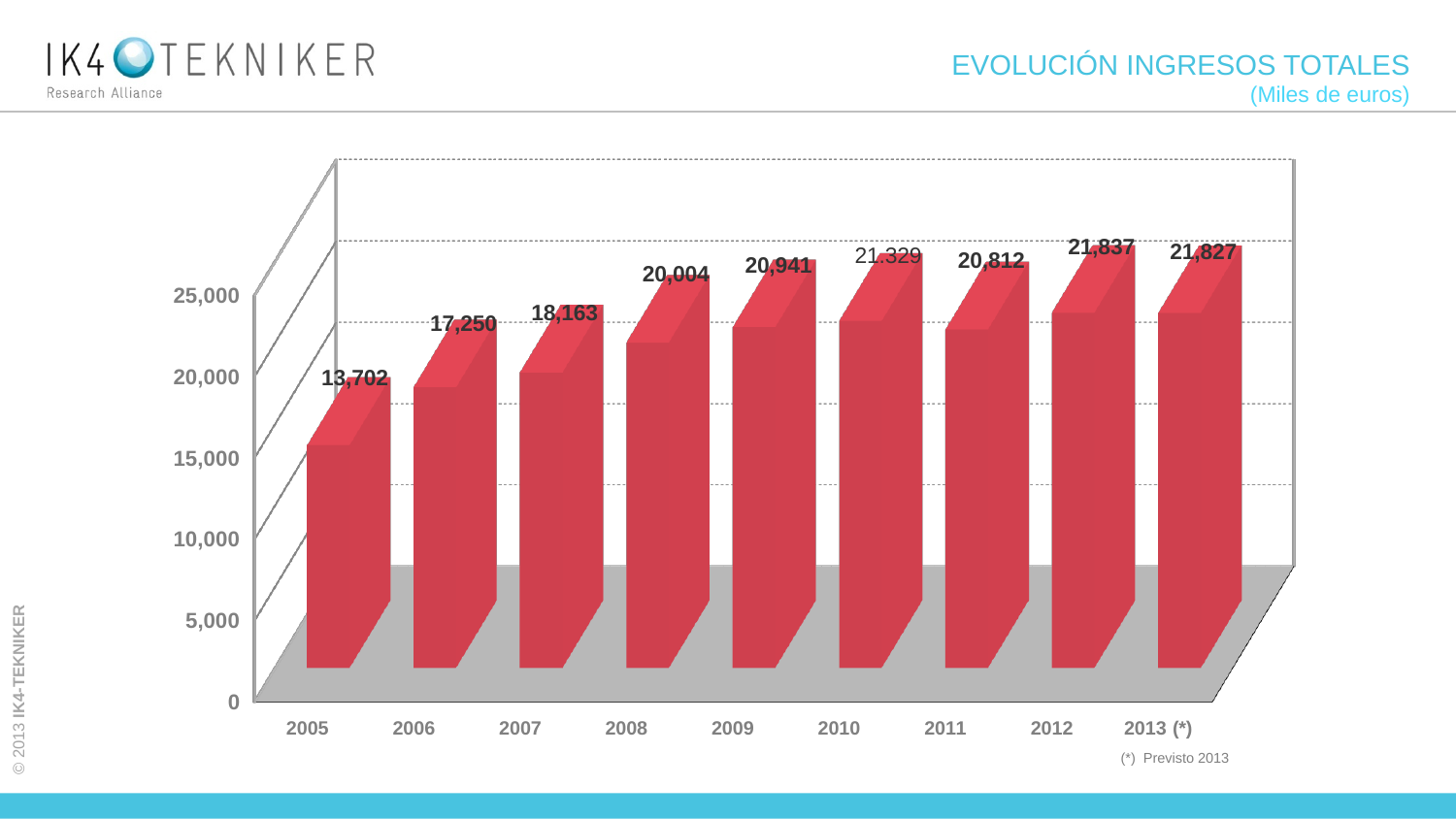
What is the difference between the values for 2012 and 2011? 1,025 Which is larger, the value for 2009 or the value for 2011? 2009 How many years are shown on the x axis? 9 What is the value for 2005? 13,702 What kind of chart is shown on the slide? Bar chart What is the value for 2013 (*)? 21,827 Do the values generally rise or fall from 2005 to 2013? Rise What is the value for 2010? 21,329 What is the difference between the values for 2006 and 2005? 3,548 What unit is stated under the chart title? Miles de euros Which year has the lowest value? 2005 Which year has the highest value? 2012